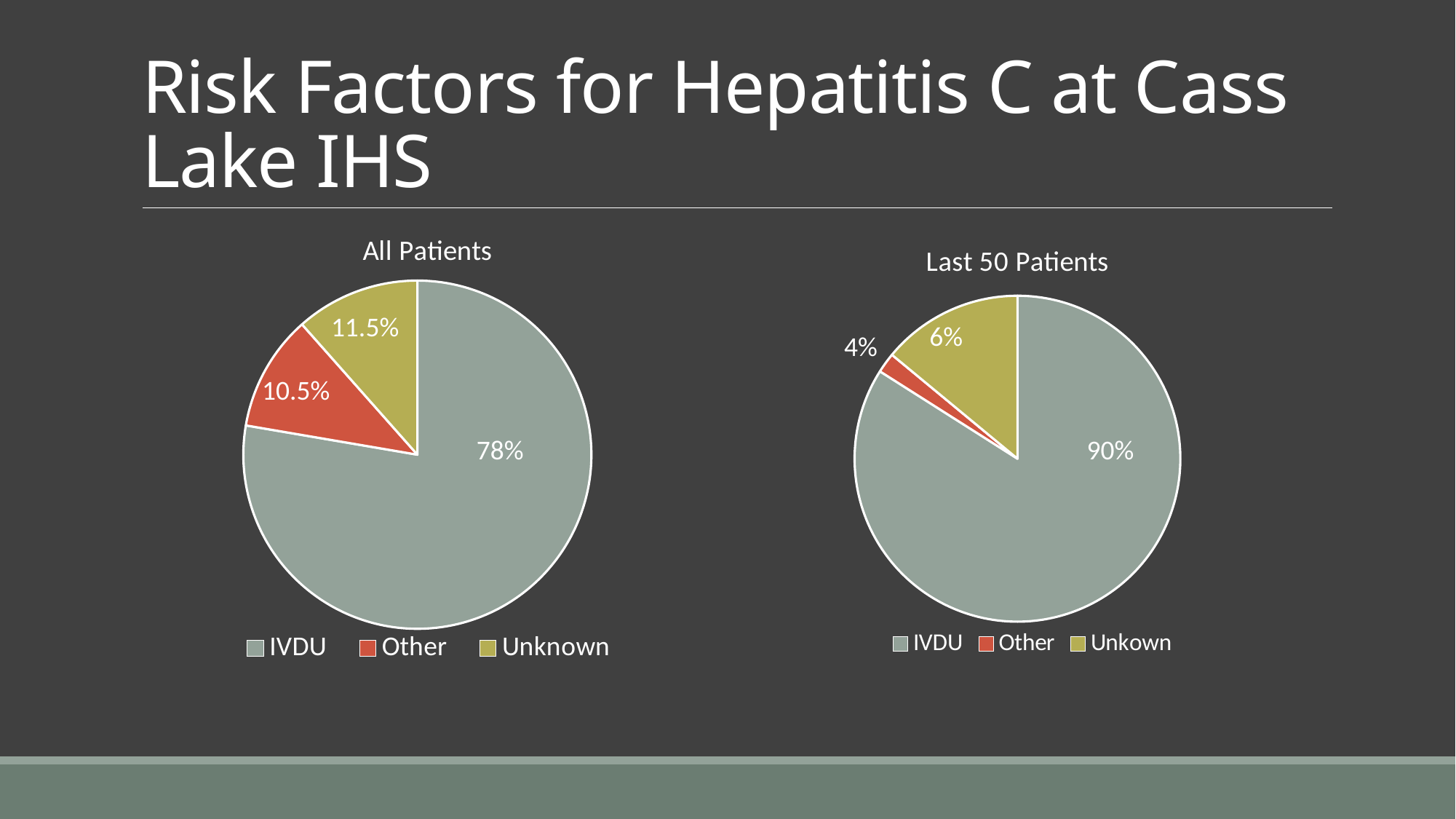
In the "All Patients" pie chart, which category has the largest slice? IVDU In the "All Patients" pie chart, what percentage is shown for Unknown? 11.5% In the "Last 50 Patients" pie chart, is the Unkown slice larger or smaller than the Other slice? larger In the "All Patients" pie chart, what percentage is shown for IVDU? 78% How many categories does the legend of the "Last 50 Patients" chart list? 3 In the "Last 50 Patients" pie chart, what percentage is shown for Other? 4% In the "Last 50 Patients" pie chart, which category has the smallest slice? Other In the "Last 50 Patients" pie chart, what percentage is shown for IVDU? 90% In the "All Patients" pie chart, what is the difference between the Unknown and Other percentages? 1% In the "All Patients" pie chart, what percentage is shown for Other? 10.5% In the "All Patients" pie chart, what colour is the Other slice? red What type of chart is the "All Patients" chart? pie chart